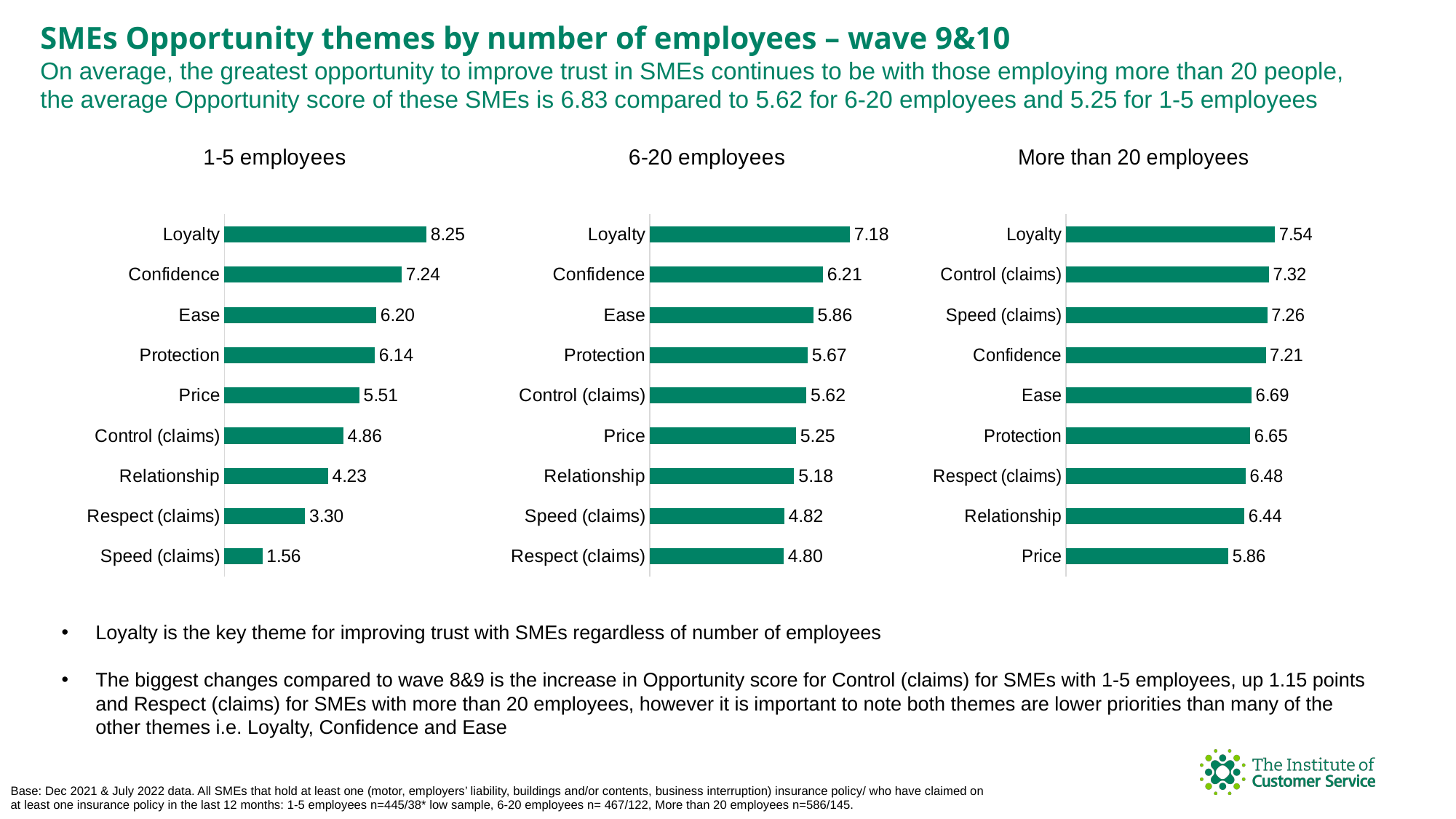
In the '6-20 employees' chart, what is the value for Control (claims)? 5.62 In the 'More than 20 employees' chart, which category has the highest value? Loyalty In the '1-5 employees' chart, what is the difference between Loyalty and Confidence? 1.01 In the '6-20 employees' chart, which category has the lowest value? Respect (claims) In the 'More than 20 employees' chart, what is the value for Price? 5.86 What type of chart is the '6-20 employees' chart? Bar chart In the '6-20 employees' chart, which is larger: Ease or Protection? Ease In the '1-5 employees' chart, what is the value for Loyalty? 8.25 How many charts are shown on the slide? 3 In the '1-5 employees' chart, which category has the lowest value? Speed (claims) How many categories are shown in the '1-5 employees' chart? 9 In the 'More than 20 employees' chart, what is the difference between Control (claims) and Speed (claims)? 0.06